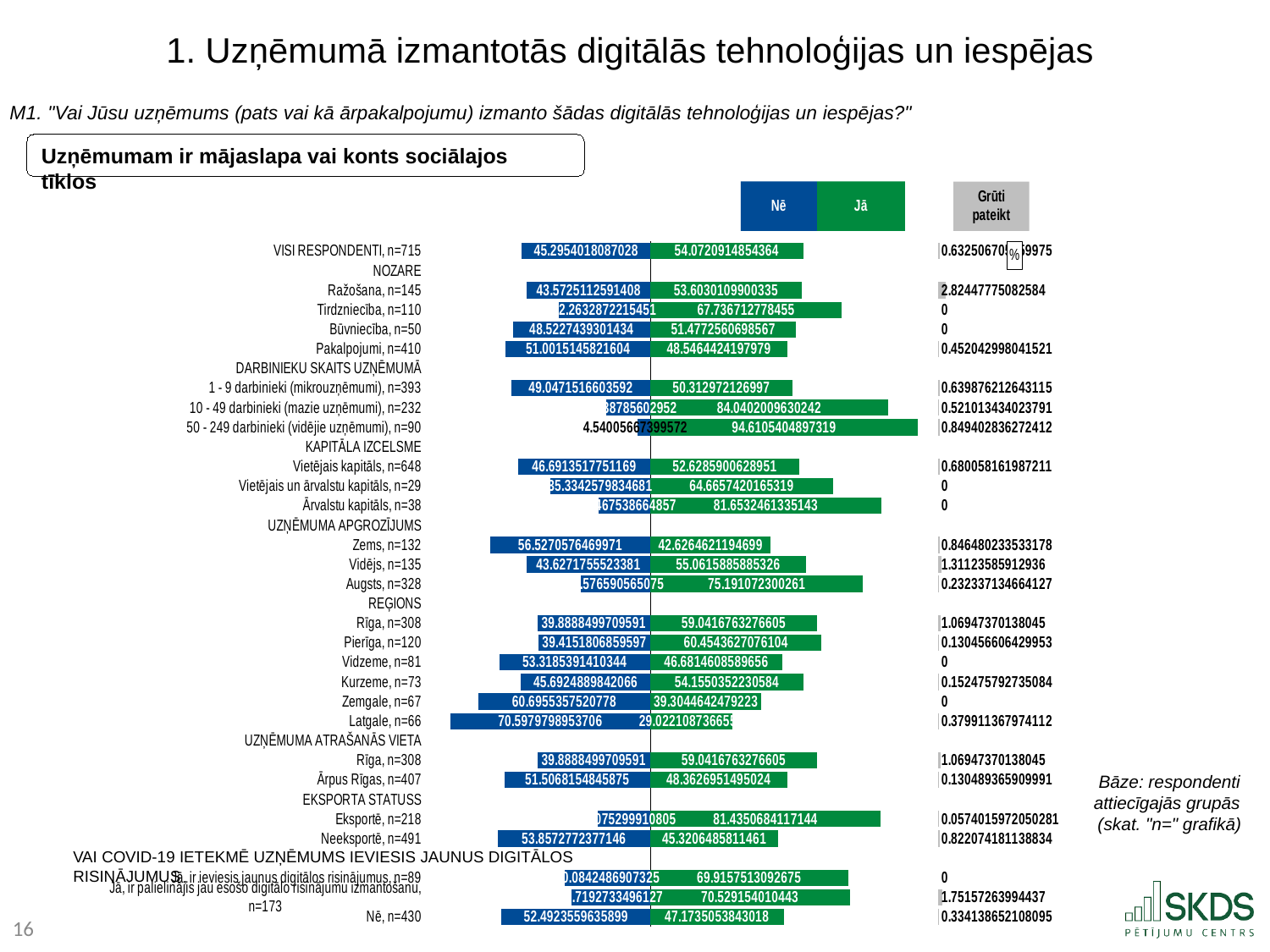
Which series is shown in green in the legend? Jā For Vidējs, n=135, which is larger: the "Nē" value or the "Jā" value? Jā How many series does the legend list? 3 What is the difference between the "Jā" and "Nē" values for VISI RESPONDENTI, n=715? 8.7766896767336 What is the "Nē" value for Zemgale, n=67? 60.6955357520778 What is the "Jā" value for Pierīga, n=120? 60.4543627076104 For Zemgale, n=67, which is larger: the "Nē" value or the "Jā" value? Nē What is the "Jā" value for VISI RESPONDENTI, n=715? 54.0720914854364 What kind of chart is shown on the slide? bar chart What is the "Nē" value for Neeksportē, n=491? 53.8572772377146 Which category has the highest "Jā" value? 50 - 249 darbinieki (vidējie uzņēmumi), n=90 Which category has the highest "Nē" value? Latgale, n=66